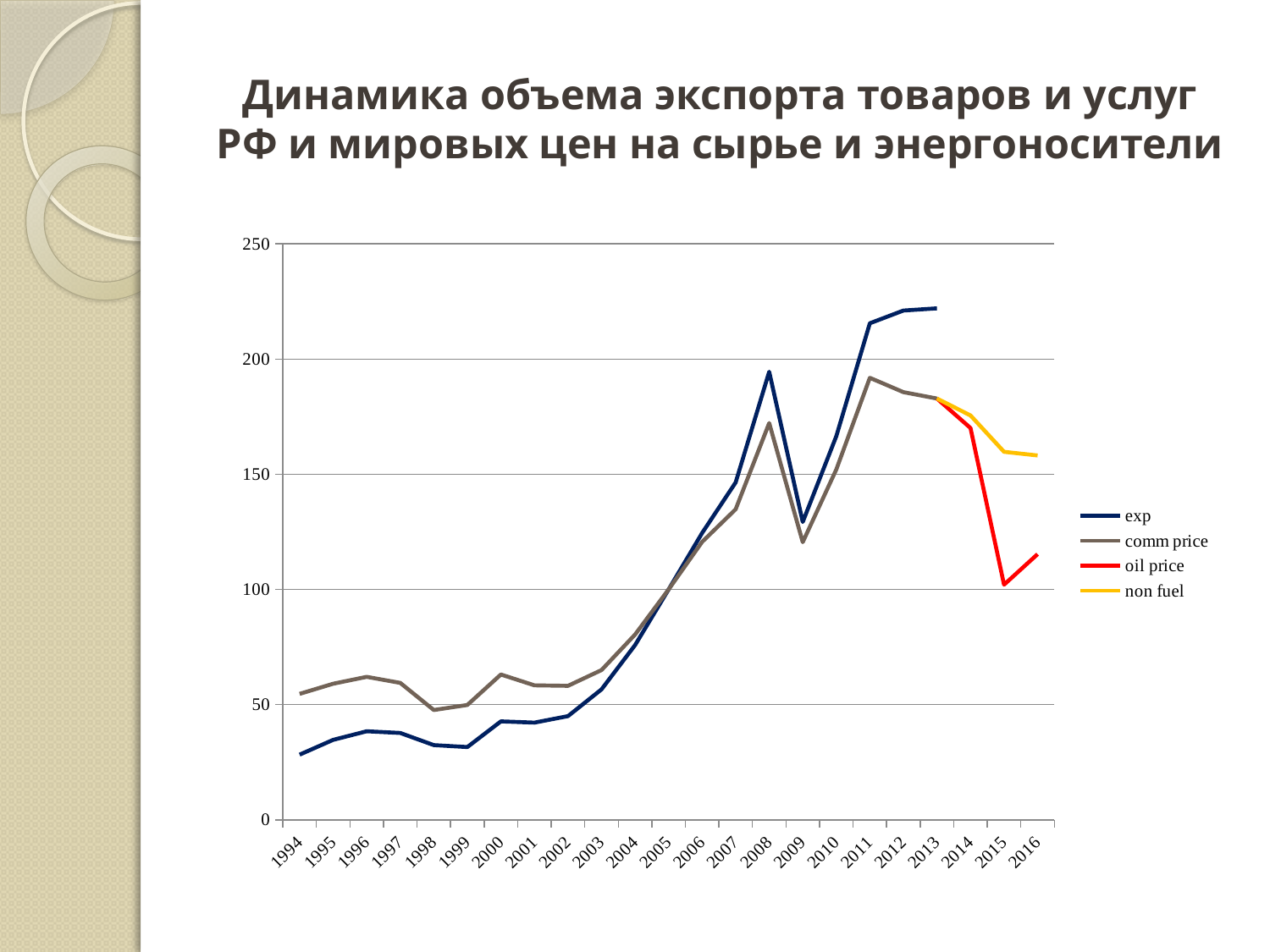
How many series does the legend list? 4 Does the oil price series rise or fall from 2013 to 2015? fall How many years are shown on the x axis? 23 Is the value of the exp series in 2013 greater or less than 200? greater In which year does the oil price series reach its lowest value? 2015 In 2015, which series has the larger value: oil price or non fuel? non fuel Is the value of the exp series in 1994 greater or less than 50? less Is the value of the oil price series in 2015 greater or less than 150? less What kind of chart is shown on the slide? line chart In which year does the comm price series reach its highest value? 2011